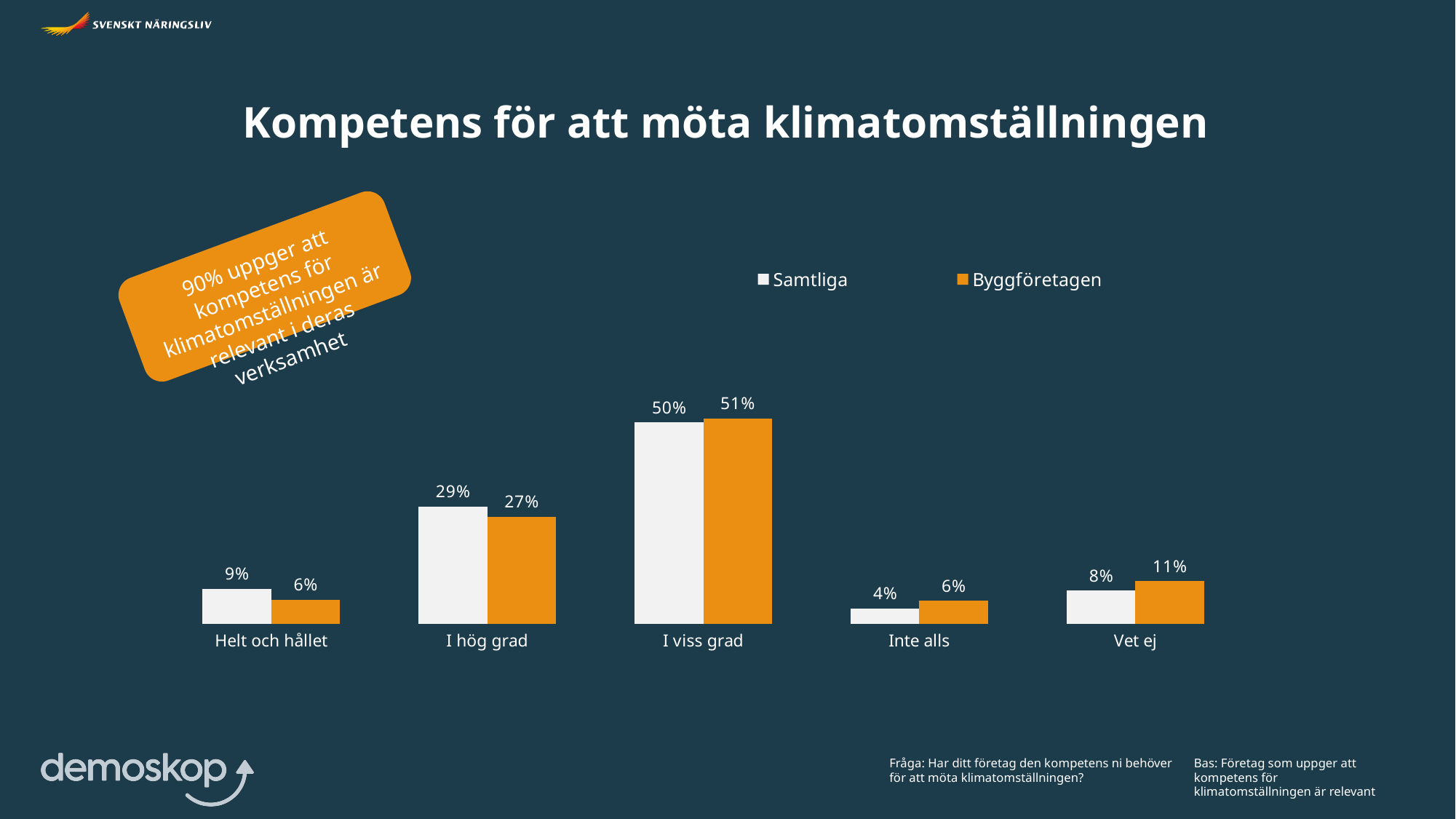
Which colour represents the Byggföretagen series? Orange What is the value for Samtliga in the 'Helt och hållet' category? 9% What is the difference between Samtliga and Byggföretagen in the 'I hög grad' category? 2% How many series does the legend list? 2 What kind of chart is shown on the slide? Bar chart What is the value for Byggföretagen in the 'I hög grad' category? 27% How many categories are shown on the x axis? 5 What is the value for Samtliga in the 'I viss grad' category? 50% Which category has the lowest value for Samtliga? Inte alls Which is larger in the 'Inte alls' category, Samtliga or Byggföretagen? Byggföretagen Which category has the highest value for Byggföretagen? I viss grad What is the value for Byggföretagen in the 'Vet ej' category? 11%